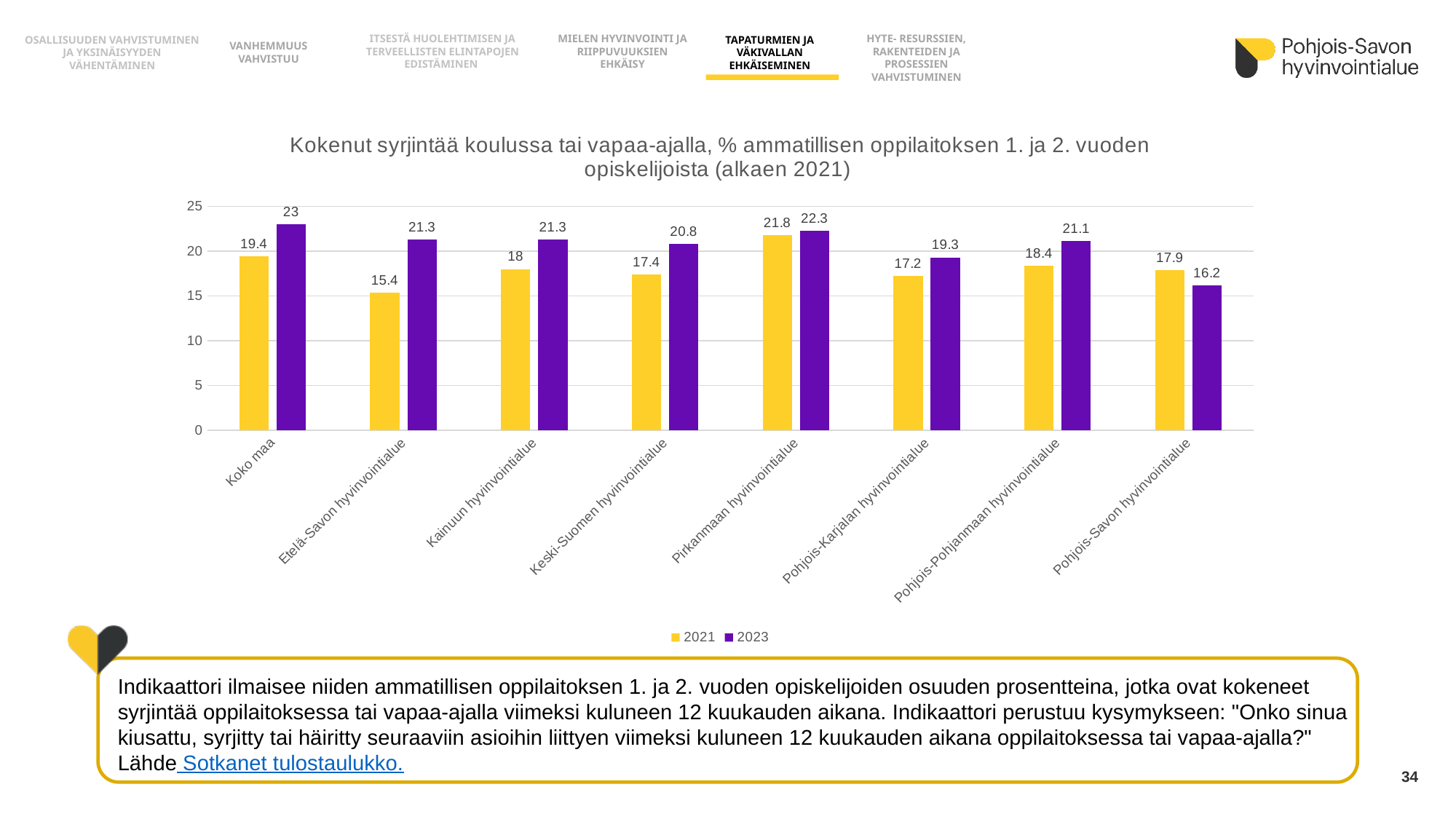
Which category has the lowest 2023 value? Pohjois-Savon hyvinvointialue Which category has the highest 2023 value? Koko maa What is the 2023 value for Etelä-Savon hyvinvointialue? 21.3 What is the difference between the 2023 and 2021 values for Etelä-Savon hyvinvointialue? 5.9 Is the 2023 value for Keski-Suomen hyvinvointialue greater or less than 20? greater Which category has the lowest 2021 value? Etelä-Savon hyvinvointialue How many categories are shown on the x axis? 8 What kind of chart is shown on the slide? Bar chart What is the 2021 value for Pohjois-Savon hyvinvointialue? 17.9 How many series does the legend list? 2 For Pohjois-Savon hyvinvointialue, which is larger: the 2021 value or the 2023 value? 2021 What is the 2021 value for Koko maa? 19.4